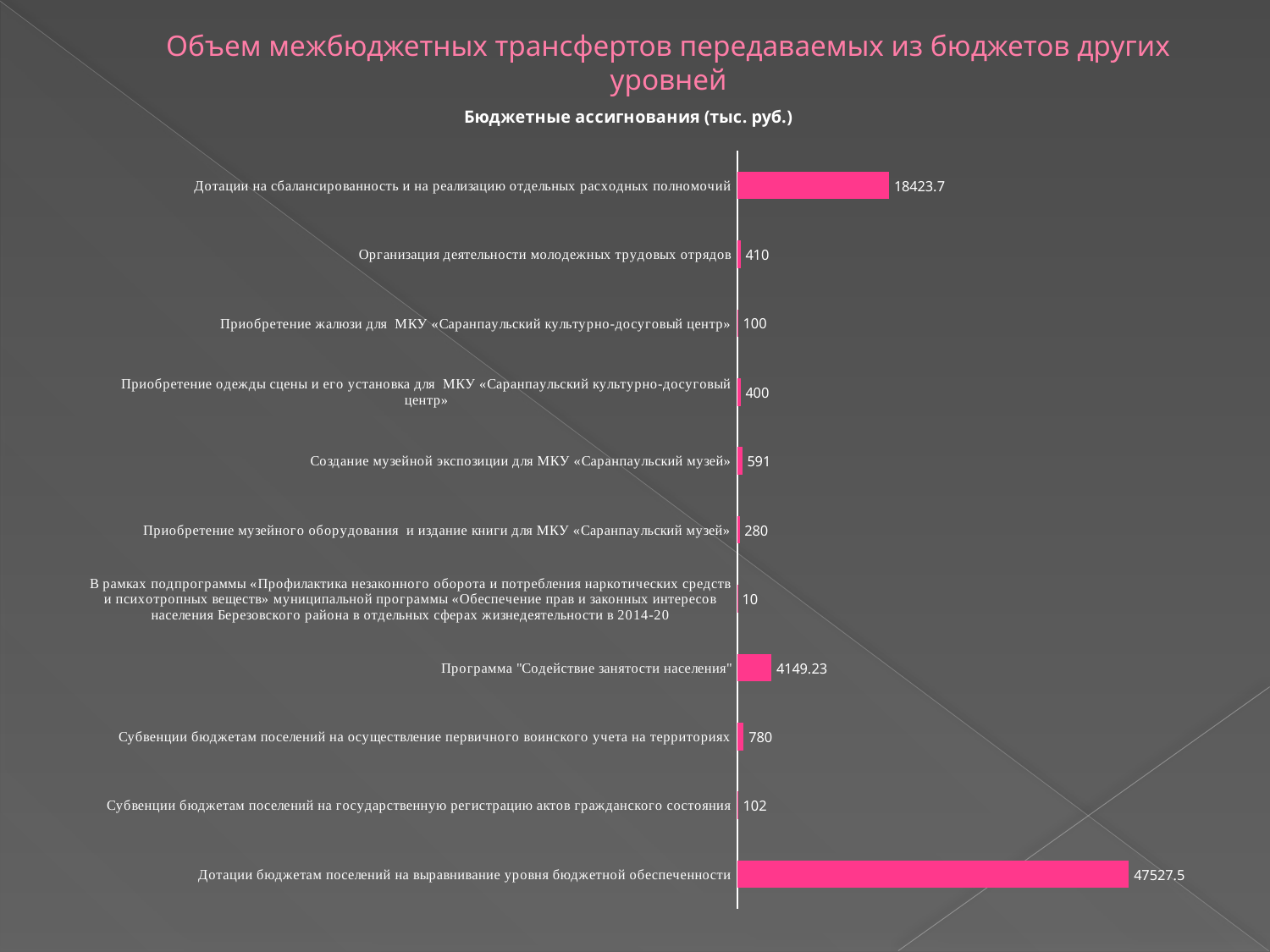
Which is larger: the value for "Организация деятельности молодежных трудовых отрядов" or the value for "Субвенции бюджетам поселений на осуществление первичного воинского учета на территориях"? Субвенции бюджетам поселений на осуществление первичного воинского учета на территориях Which category has the highest value? Дотации бюджетам поселений на выравнивание уровня бюджетной обеспеченности What is the value for "Программа "Содействие занятости населения""? 4149.23 What is the difference between the values for "Субвенции бюджетам поселений на осуществление первичного воинского учета на территориях" and "Приобретение музейного оборудования и издание книги для МКУ «Саранпаульский музей»"? 500 What is the value for "Дотации бюджетам поселений на выравнивание уровня бюджетной обеспеченности"? 47527.5 How many categories are shown in the chart? 11 What is the title of the chart? Бюджетные ассигнования (тыс. руб.) What is the value for "Дотации на сбалансированность и на реализацию отдельных расходных полномочий"? 18423.7 What is the difference between the values for "Дотации бюджетам поселений на выравнивание уровня бюджетной обеспеченности" and "Дотации на сбалансированность и на реализацию отдельных расходных полномочий"? 29103.8 What type of chart is shown on the slide? bar chart What is the value for "Создание музейной экспозиции для МКУ «Саранпаульский музей»"? 591